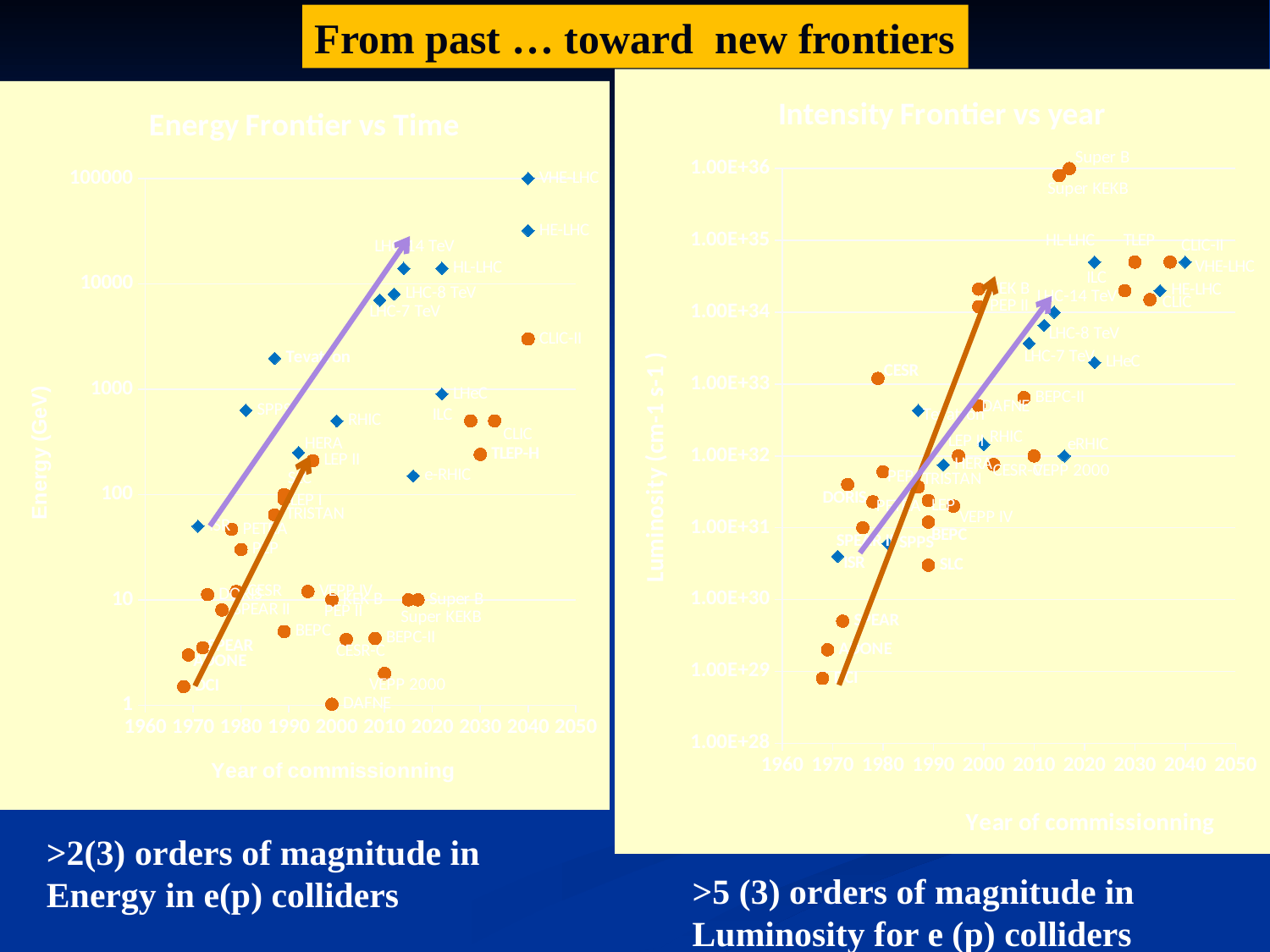
In the 'Intensity Frontier vs year' chart, which collider has the highest luminosity? Super B In the 'Energy Frontier vs Time' chart, is the energy for DAFNE greater or less than 10? less In the 'Energy Frontier vs Time' chart, do energies generally rise or fall with later years of commissioning? rise In the 'Energy Frontier vs Time' chart, is the energy for HE-LHC greater or less than 10000? greater In the 'Intensity Frontier vs year' chart, is the luminosity for Super B greater or less than 1.00E+35? greater In the 'Energy Frontier vs Time' chart, which collider has the highest energy? VHE-LHC In the 'Energy Frontier vs Time' chart, which has the higher energy, Tevatron or LHeC? Tevatron In the 'Energy Frontier vs Time' chart, what is the label of the x axis? Year of commissionning What kind of chart is the 'Energy Frontier vs Time' chart on the left? scatter chart What is the title of the chart on the right side of the slide? Intensity Frontier vs year